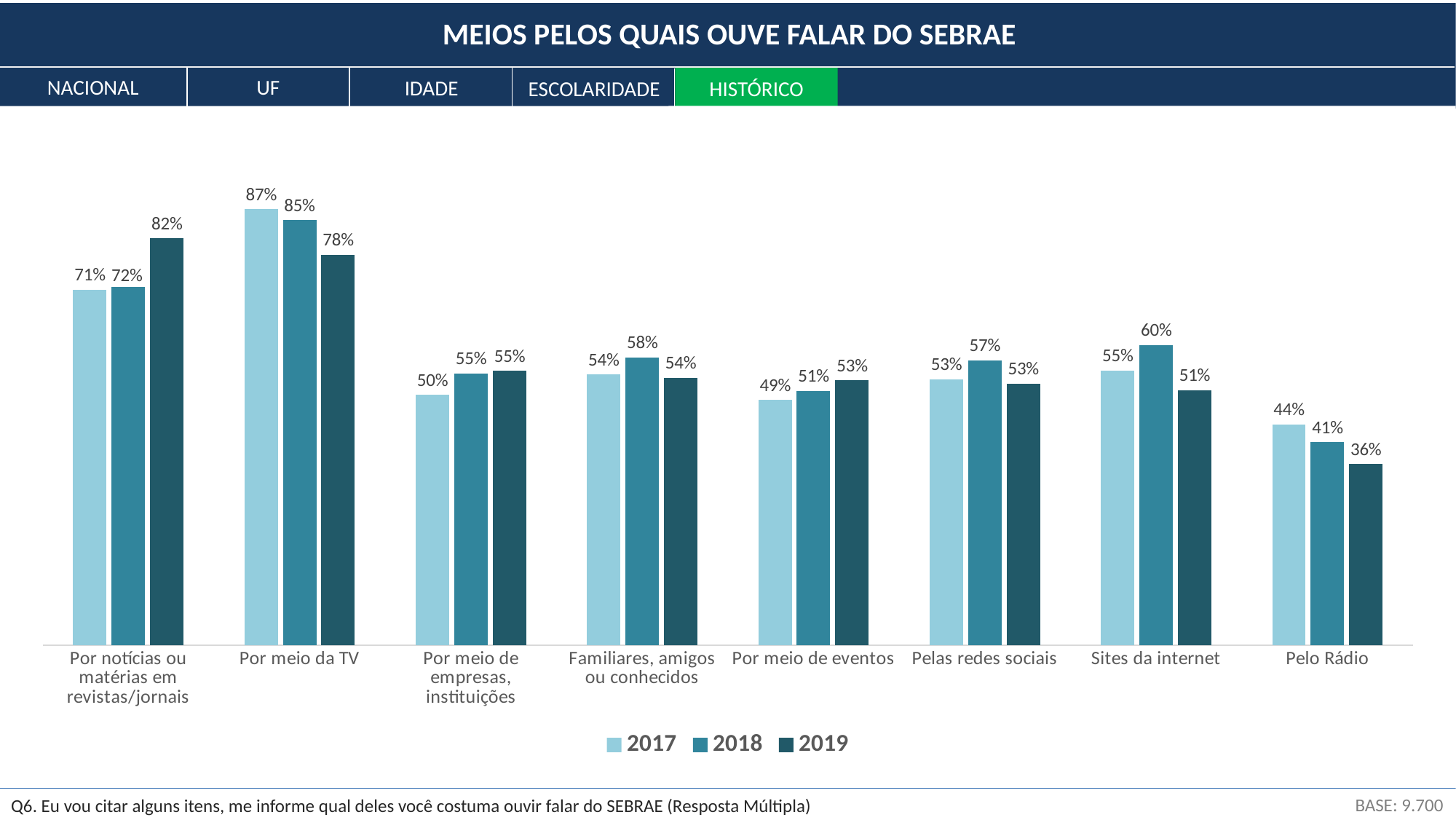
What is the 2017 value for "Pelo Rádio"? 44% What is the 2018 value for "Sites da internet"? 60% How many series does the legend list? 3 How many categories are shown on the x axis? 8 Which category has the lowest 2019 value? Pelo Rádio What is the 2019 value for "Por meio da TV"? 78% What is the difference between the 2019 and 2017 values for "Por notícias ou matérias em revistas/jornais"? 11 percentage points What is the title of the chart? MEIOS PELOS QUAIS OUVE FALAR DO SEBRAE Which category has the highest 2017 value? Por meio da TV Do the values for "Pelo Rádio" rise or fall from 2017 to 2019? Fall What kind of chart is shown on the slide? Bar chart Which is larger for "Pelas redes sociais": the 2018 value or the 2019 value? 2018